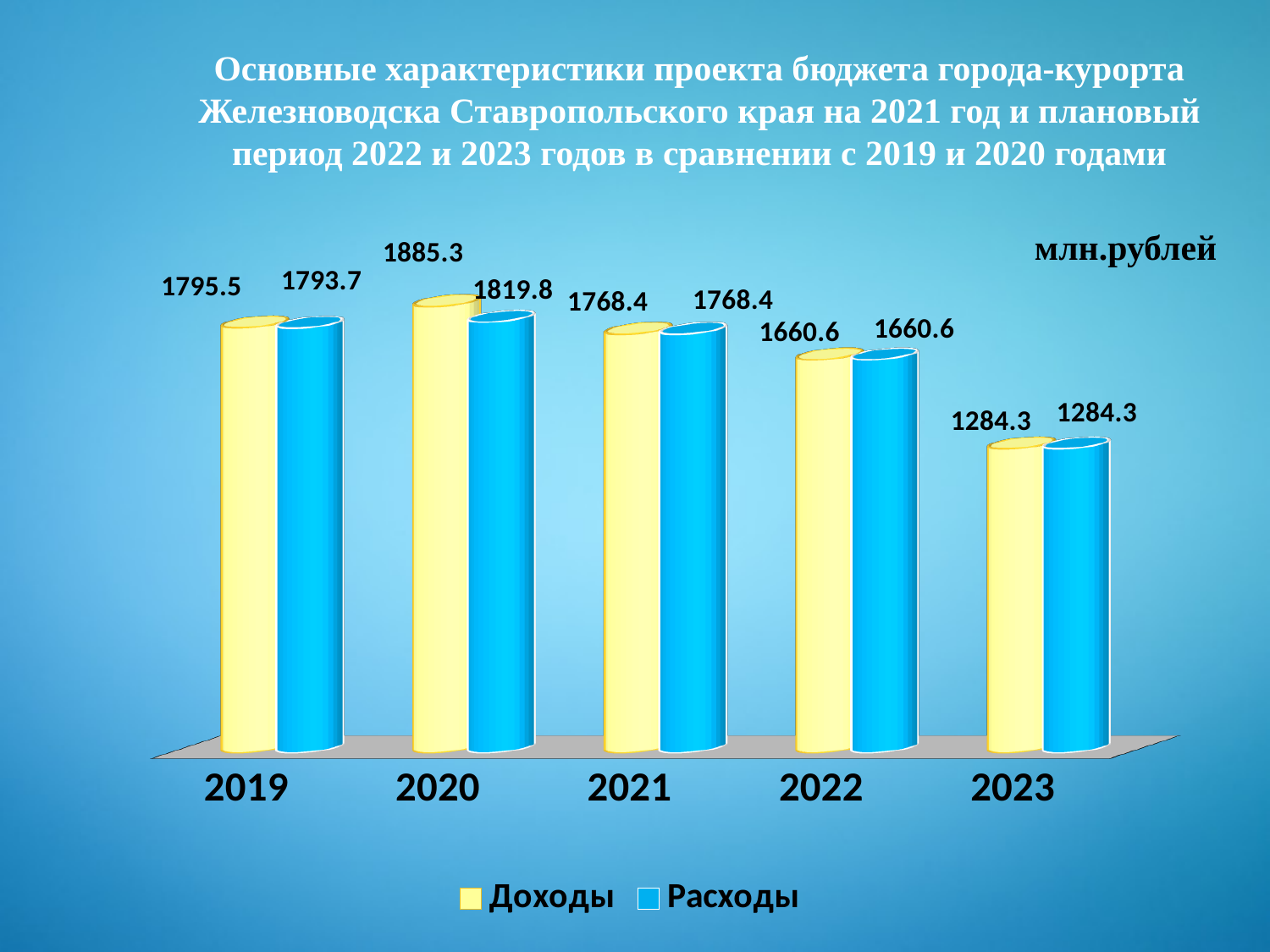
In which year is Расходы the lowest? 2023 What is the value of Доходы for 2020? 1885.3 What is the difference between Доходы in 2019 and Доходы in 2023? 511.2 What kind of chart is shown on the slide? Bar chart In which year is Доходы the highest? 2020 How many years are shown on the x axis? 5 What unit is indicated for the values on the chart? млн.рублей How many series does the legend list? 2 What is the value of Расходы for 2019? 1793.7 Which is larger in 2020: Доходы or Расходы? Доходы What is the difference between Доходы and Расходы in 2020? 65.5 What is the value of Расходы for 2023? 1284.3